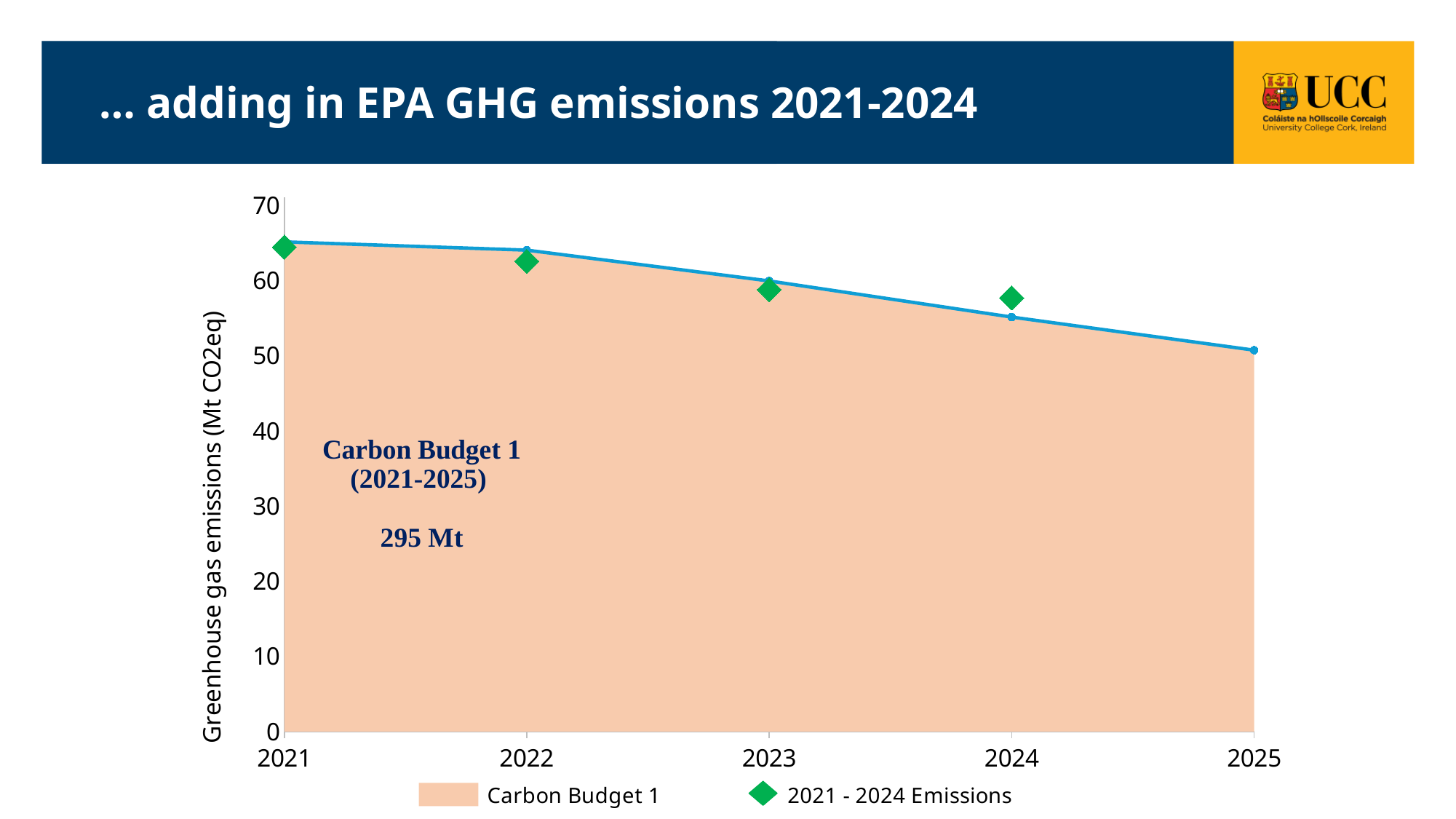
How many green diamond markers for 2021 - 2024 Emissions are plotted? 4 Does the Carbon Budget 1 line rise or fall from 2021 to 2025? Fall What total is annotated inside the Carbon Budget 1 area? 295 Mt How many series does the legend list? 2 How many years are shown on the x axis? 5 Is the Carbon Budget 1 value for 2025 greater or less than 60? less In which year is the Carbon Budget 1 value highest? 2021 What kind of chart is shown on the slide? Area chart In which year is the Carbon Budget 1 value lowest? 2025 In 2024, which is larger: the 2021 - 2024 Emissions marker or the Carbon Budget 1 value? 2021 - 2024 Emissions What is the label on the y axis? Greenhouse gas emissions (Mt CO2eq) Is the 2021 - 2024 Emissions value for 2024 greater or less than 50? greater